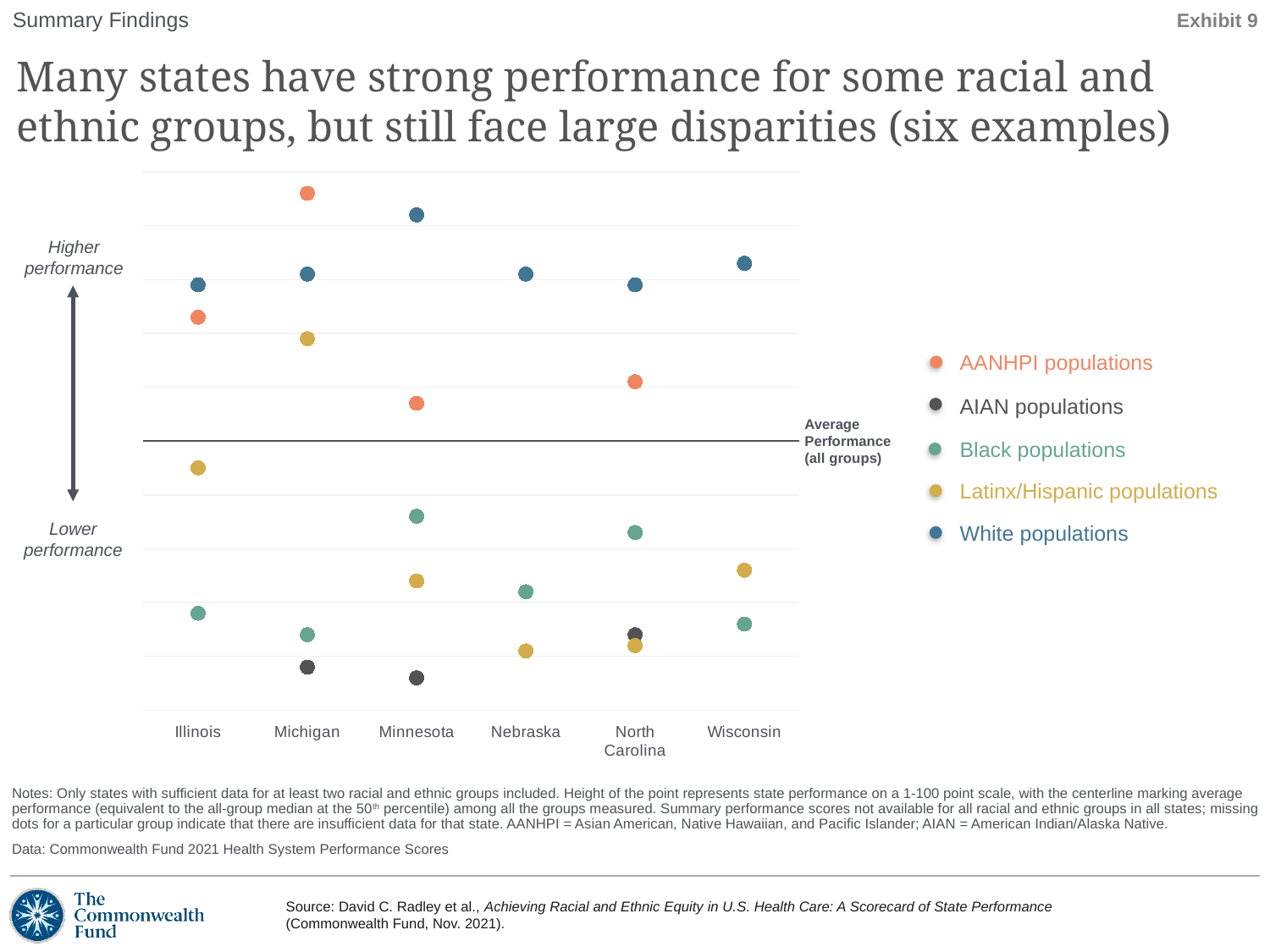
How many population groups does the legend list? 5 Which state has the single highest-performing point on the chart? Michigan What kind of chart is shown on the slide? dot plot Which state has the single lowest-performing point on the chart? Minnesota How many states are shown along the x axis of the chart? 6 Across the states shown, which state has the highest point for Latinx/Hispanic populations? Michigan In Michigan, which population group has the lowest performance? AIAN populations What does the horizontal black line across the chart represent? Average Performance (all groups) In Illinois, which population group has the lowest performance? Black populations In Michigan, which population group has the highest performance? AANHPI populations In Minnesota, is the performance for White populations or Black populations higher? White populations